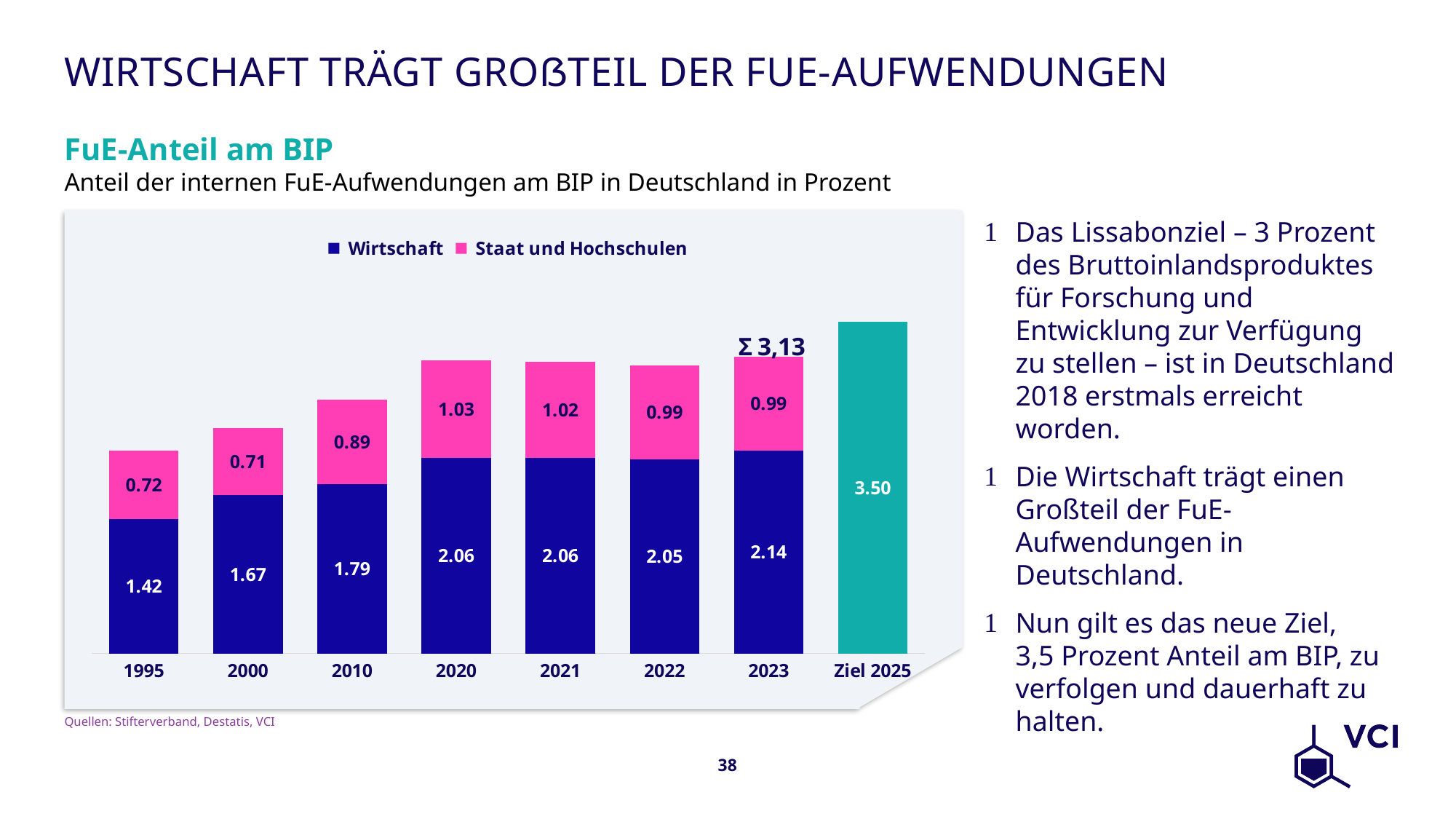
What value is shown for the Ziel 2025 bar? 3.50 What is the difference between the Wirtschaft values for 2023 and 1995? 0.72 What total is printed above the 2023 bar? Σ 3,13 How many series does the legend list? 2 Which year has the lowest Wirtschaft value? 1995 What kind of chart is shown on the slide? Stacked bar chart Which year has the highest Staat und Hochschulen value? 2020 What is the Wirtschaft value for 2023? 2.14 What is the total of the stacked bar for 2020? 3.09 Which is larger, the Wirtschaft value for 2000 or for 2010? 2010 How many categories are shown on the x axis? 8 What is the Staat und Hochschulen value for 2010? 0.89